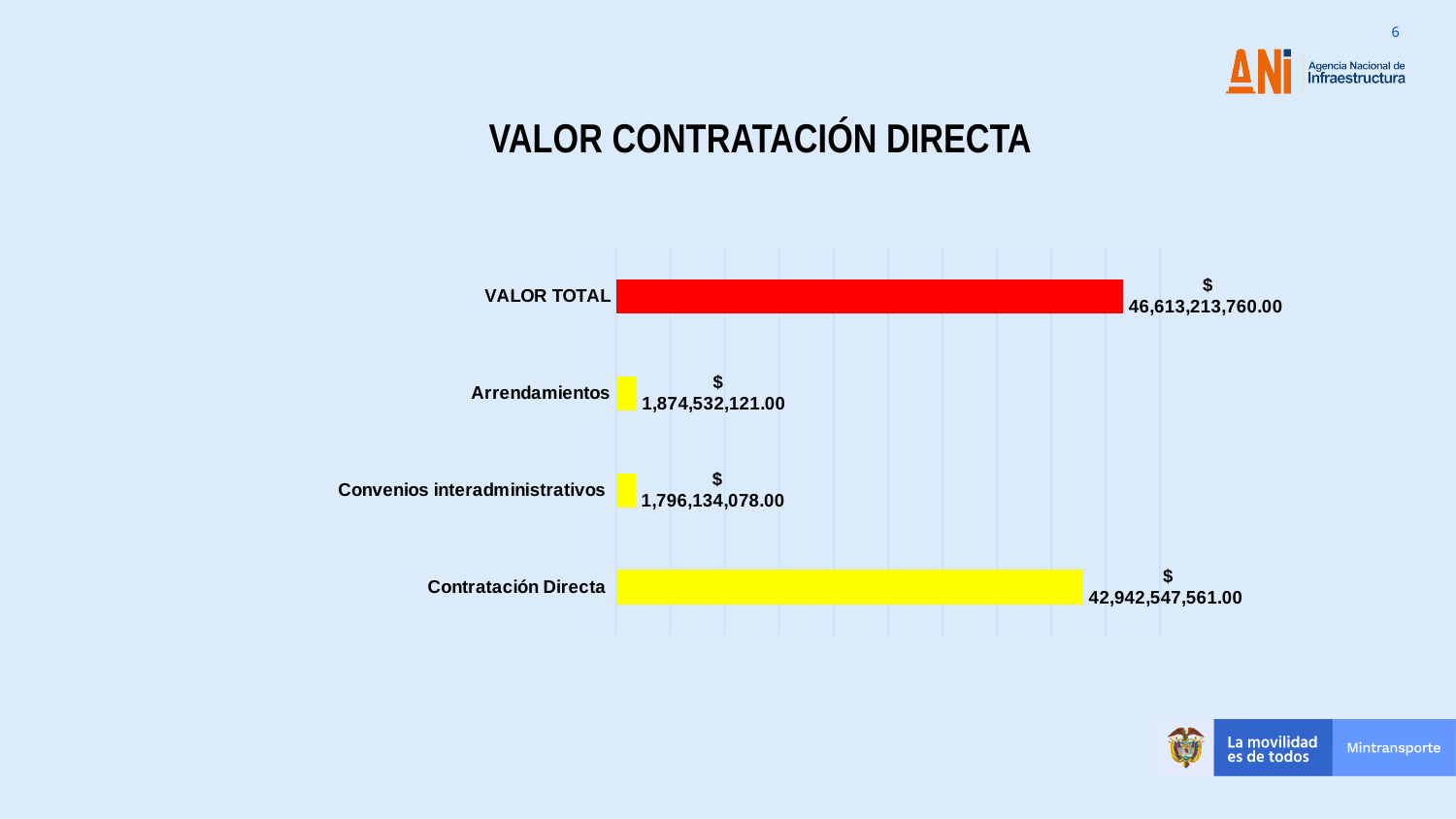
What is the value for Arrendamientos? $ 1,874,532,121.00 What type of chart is shown on the slide? Bar chart Which bar is coloured red rather than yellow? VALOR TOTAL What is the value for VALOR TOTAL? $ 46,613,213,760.00 How many categories are plotted in the chart? 4 Which category has the highest value? VALOR TOTAL What is the difference between the value for VALOR TOTAL and the value for Contratación Directa? $ 3,670,666,199.00 What is the title of the chart? VALOR CONTRATACIÓN DIRECTA Which is larger, the value for Arrendamientos or the value for Convenios interadministrativos? Arrendamientos Which category has the lowest value? Convenios interadministrativos What is the value for Contratación Directa? $ 42,942,547,561.00 What is the value for Convenios interadministrativos? $ 1,796,134,078.00